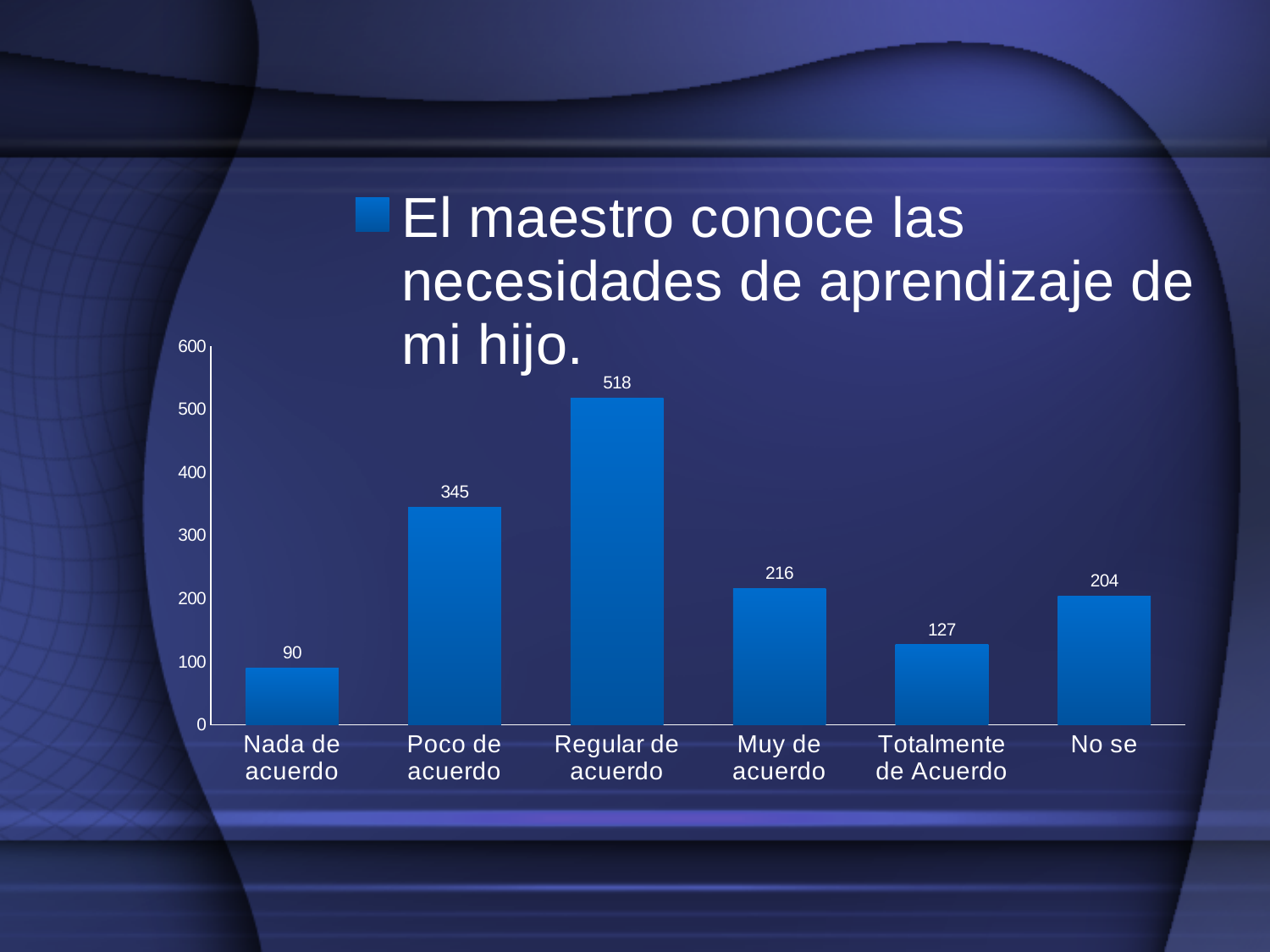
Which category has the highest value? Regular de acuerdo What is the difference between the values for "Regular de acuerdo" and "Poco de acuerdo"? 173 What is the value for "No se"? 204 Is the value for "Poco de acuerdo" greater or less than 300? greater How many categories are shown on the x axis? 6 Which category has the lowest value? Nada de acuerdo Which is larger, the value for "Muy de acuerdo" or the value for "No se"? Muy de acuerdo What is the value for "Totalmente de Acuerdo"? 127 What is the title of the chart? El maestro conoce las necesidades de aprendizaje de mi hijo. What kind of chart is shown on the slide? bar chart What is the value for "Regular de acuerdo"? 518 What is the value for "Nada de acuerdo"? 90